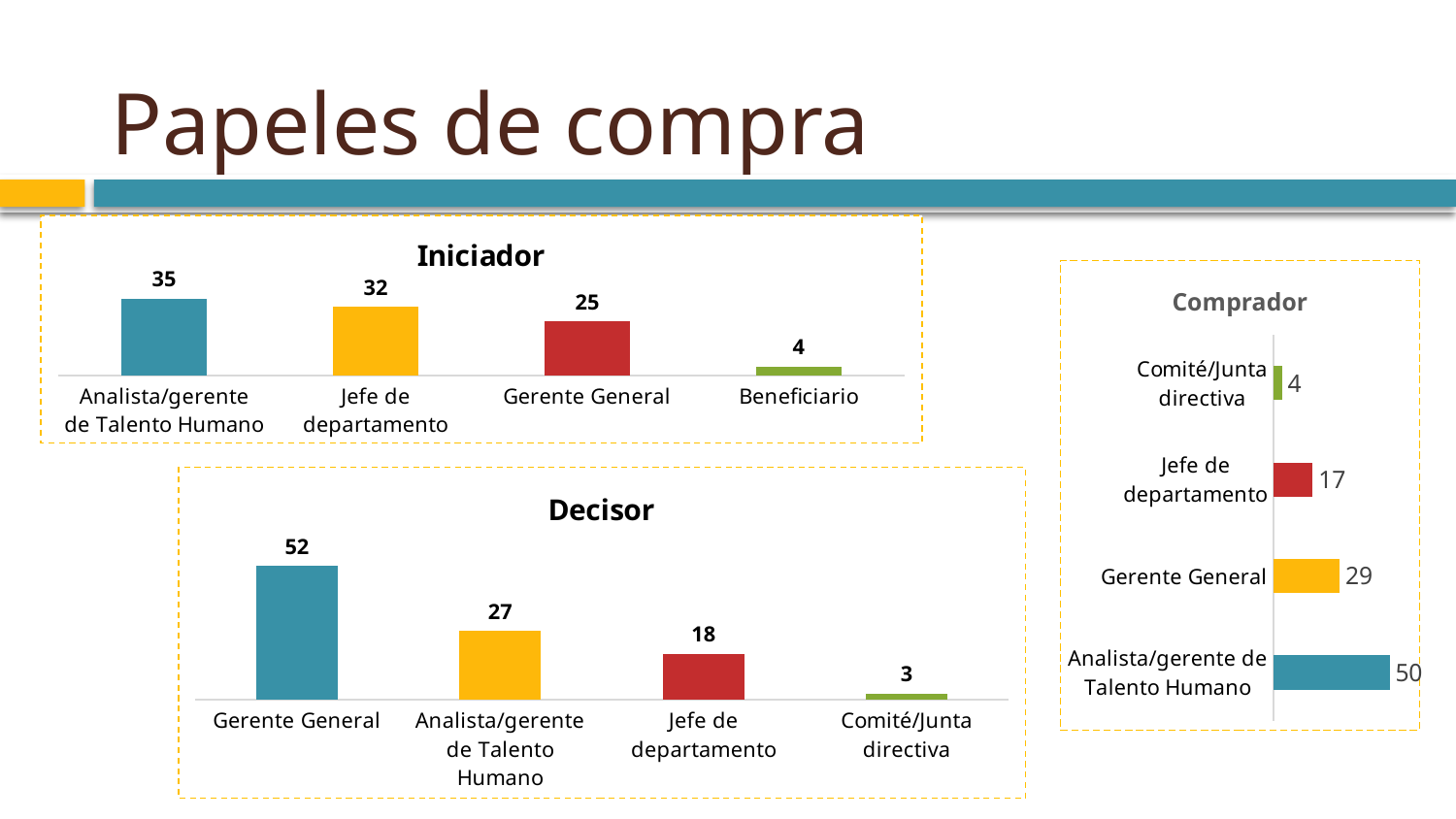
In the 'Decisor' chart, do the values rise or fall from left to right? Fall In the 'Comprador' chart, which is larger: Gerente General or Comité/Junta directiva? Gerente General In the 'Decisor' chart, which category has the highest value? Gerente General In the 'Decisor' chart, what is the value for Gerente General? 52 In the 'Comprador' chart, what is the value for Jefe de departamento? 17 In the 'Iniciador' chart, which category has the lowest value? Beneficiario In the 'Comprador' chart, which category has the highest value? Analista/gerente de Talento Humano In the 'Decisor' chart, how many categories are shown? 4 In the 'Iniciador' chart, what is the difference between Jefe de departamento and Gerente General? 7 In the 'Decisor' chart, what is the difference between Gerente General and Analista/gerente de Talento Humano? 25 What kind of chart is the 'Comprador' chart? Bar chart In the 'Iniciador' chart, what is the value for Analista/gerente de Talento Humano? 35